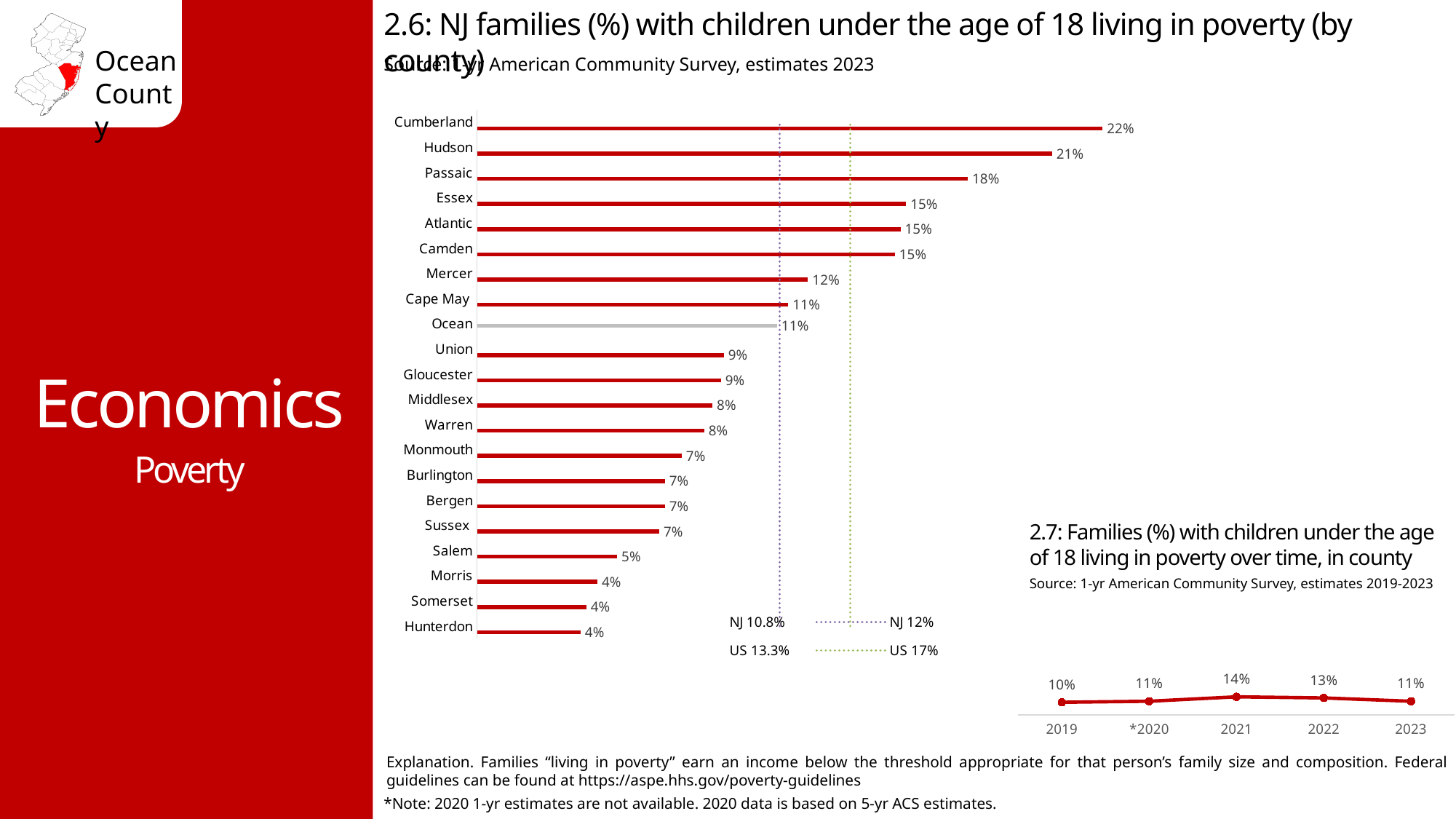
In chart 2.6, what is the value for Ocean county? 11% In chart 2.7, what is the difference between the 2021 and 2023 values? 3% What kind of chart is chart 2.7? Line chart In chart 2.6, which is larger, the value for Mercer or the value for Union? Mercer What kind of chart is chart 2.6? Bar chart In chart 2.6, which county has the highest percentage of families with children living in poverty? Cumberland In chart 2.6, how many counties are plotted? 21 In chart 2.7 (families with children under 18 living in poverty over time), what is the value for 2021? 14% In chart 2.7, which year has the lowest value? 2019 In chart 2.6 (NJ families with children under 18 living in poverty by county), what is the value for Cumberland? 22% In chart 2.6, what is the difference between the values for Hudson and Passaic? 3%